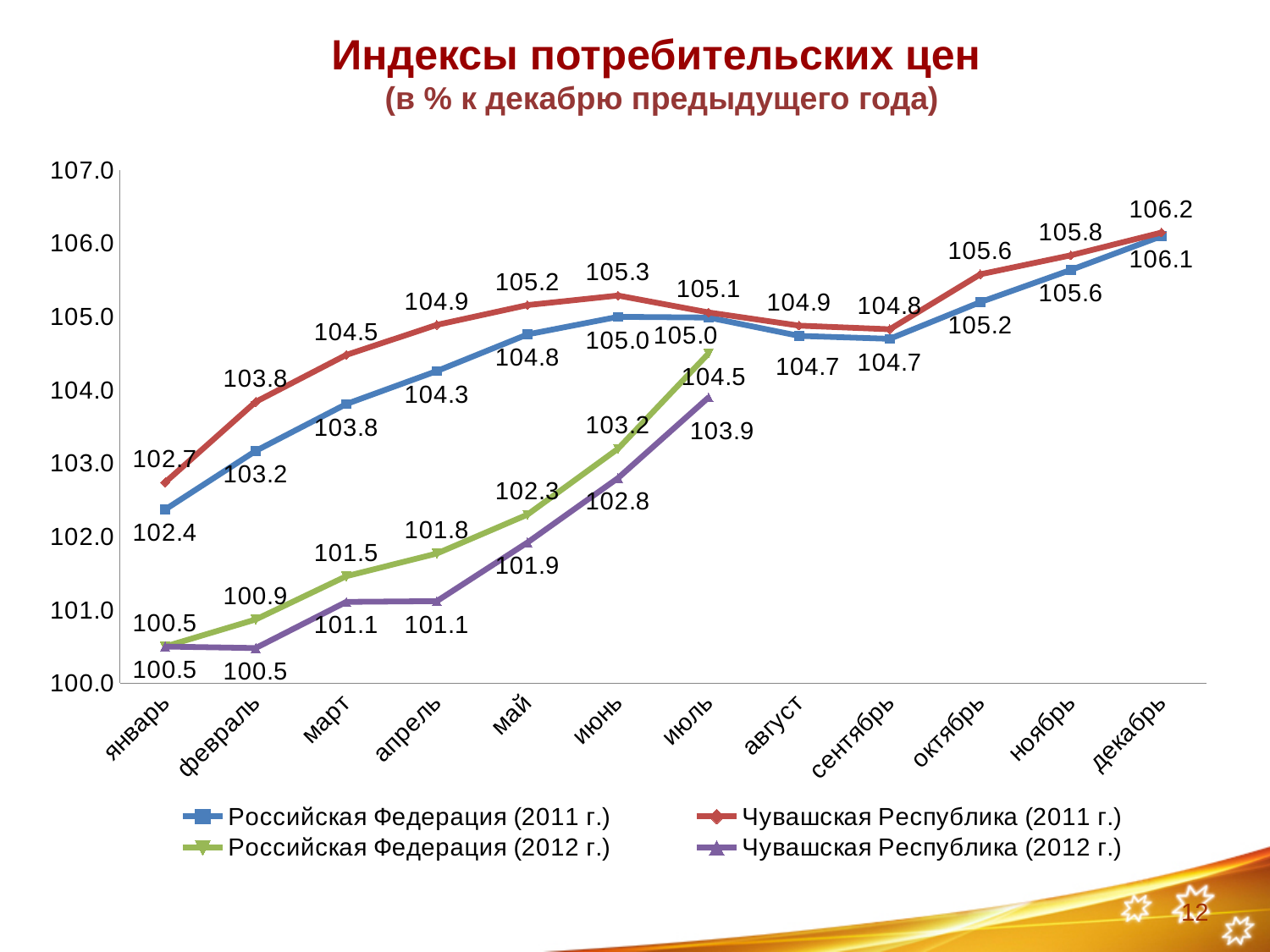
What is the value for Российская Федерация (2012 г.) in июль? 104.5 What is the value for Чувашская Республика (2012 г.) in май? 101.9 Does the Российская Федерация (2012 г.) series rise or fall from январь to июль? Rise What is the title of the chart? Индексы потребительских цен (в % к декабрю предыдущего года) How many series does the legend list? 4 How many months are shown on the x axis? 12 In which month does Чувашская Республика (2011 г.) reach its highest value? декабрь What type of chart is shown on the slide? Line chart Which is larger in июнь: Российская Федерация (2012 г.) or Чувашская Республика (2012 г.)? Российская Федерация (2012 г.) What is the value for Чувашская Республика (2011 г.) in декабрь? 106.2 What is the difference between Чувашская Республика (2011 г.) and Российская Федерация (2011 г.) in март? 0.7 What is the value for Российская Федерация (2011 г.) in апрель? 104.3